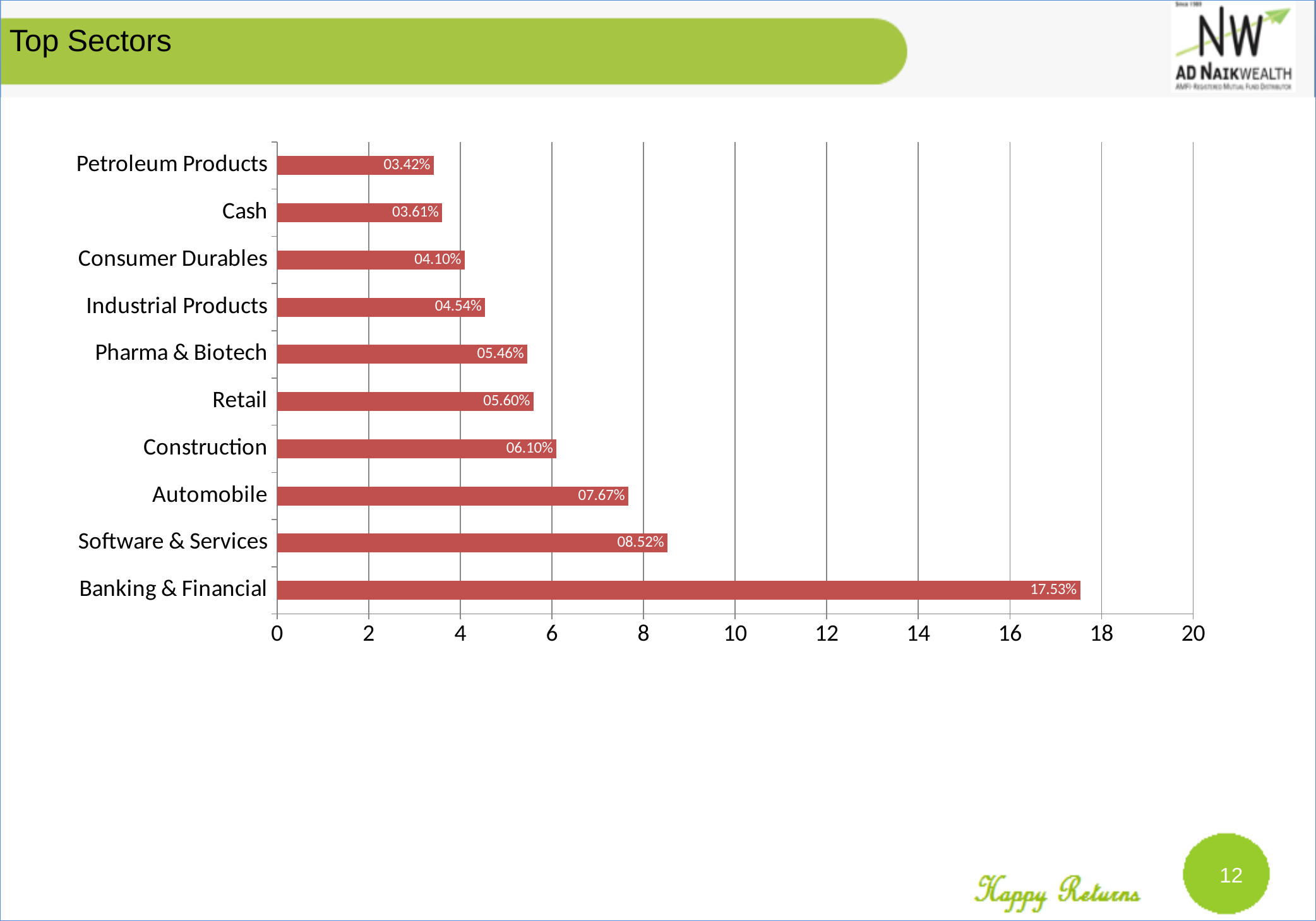
What is the value for Petroleum Products? 03.42% What is the value for Banking & Financial? 17.53% How many sectors are shown in the chart? 10 Which sector has the highest value? Banking & Financial What is the value for Software & Services? 08.52% What kind of chart is shown on the slide? Bar chart What is the difference between the values for Banking & Financial and Software & Services? 9.01% Which sector has the lowest value? Petroleum Products Which is larger, the value for Automobile or the value for Retail? Automobile What is the value for Pharma & Biotech? 05.46% What is the difference between the values for Automobile and Construction? 1.57% Is the value for Banking & Financial greater or less than 16? greater